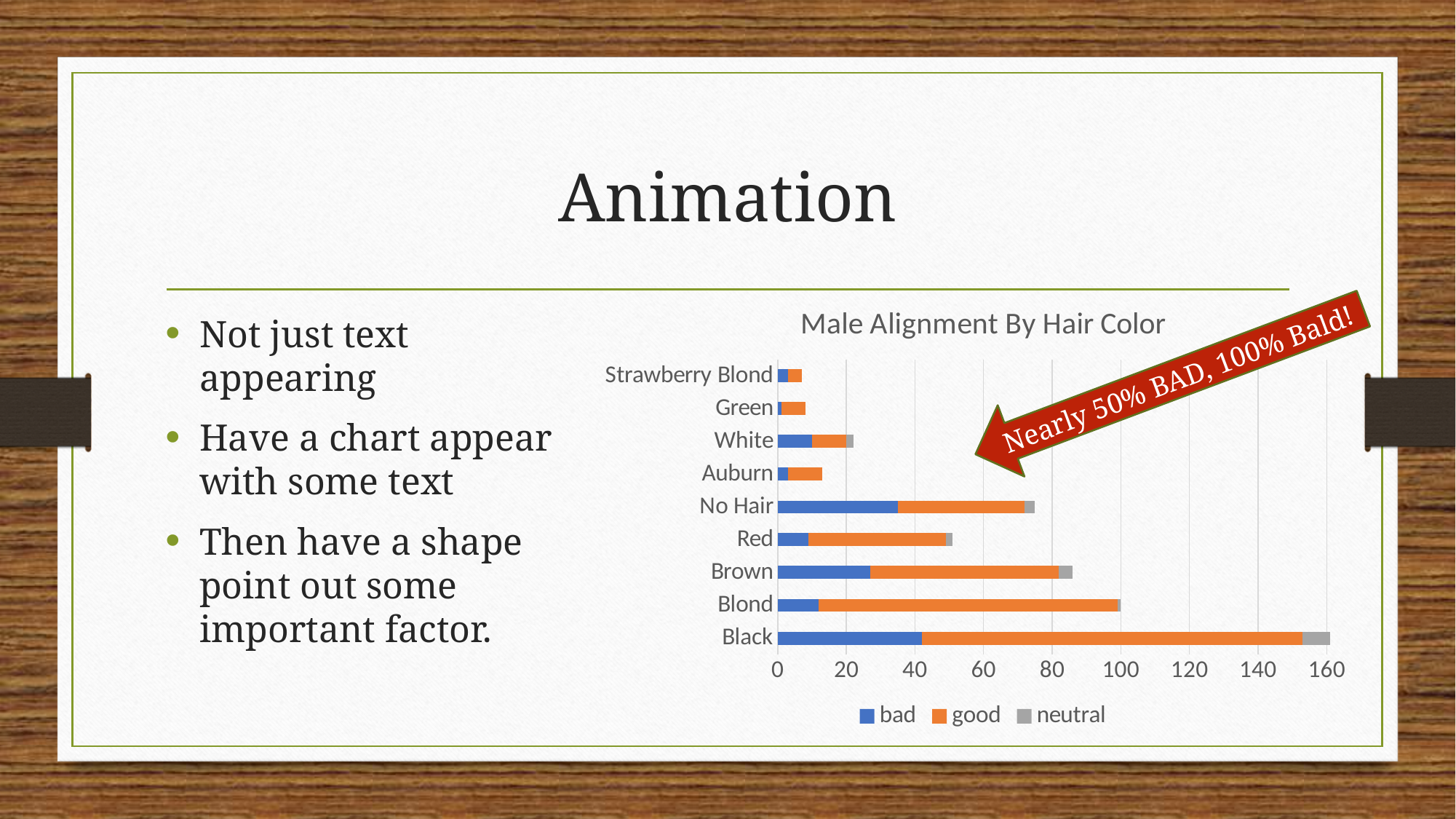
What type of chart is shown on the slide? Stacked bar chart What is the title of the chart? Male Alignment By Hair Color How many series does the chart legend list? 3 Which has a longer total bar, No Hair or Auburn? No Hair Is the total bar length for Brown greater or less than 80? greater Is the total bar length for No Hair greater or less than 80? less Is the total bar length for Black greater or less than 140? greater Which series in the legend is shown in orange? good How many hair color categories are plotted in the chart? 9 Which hair color has the longest total bar in the chart? Black Which has a longer total bar, Brown or Red? Brown